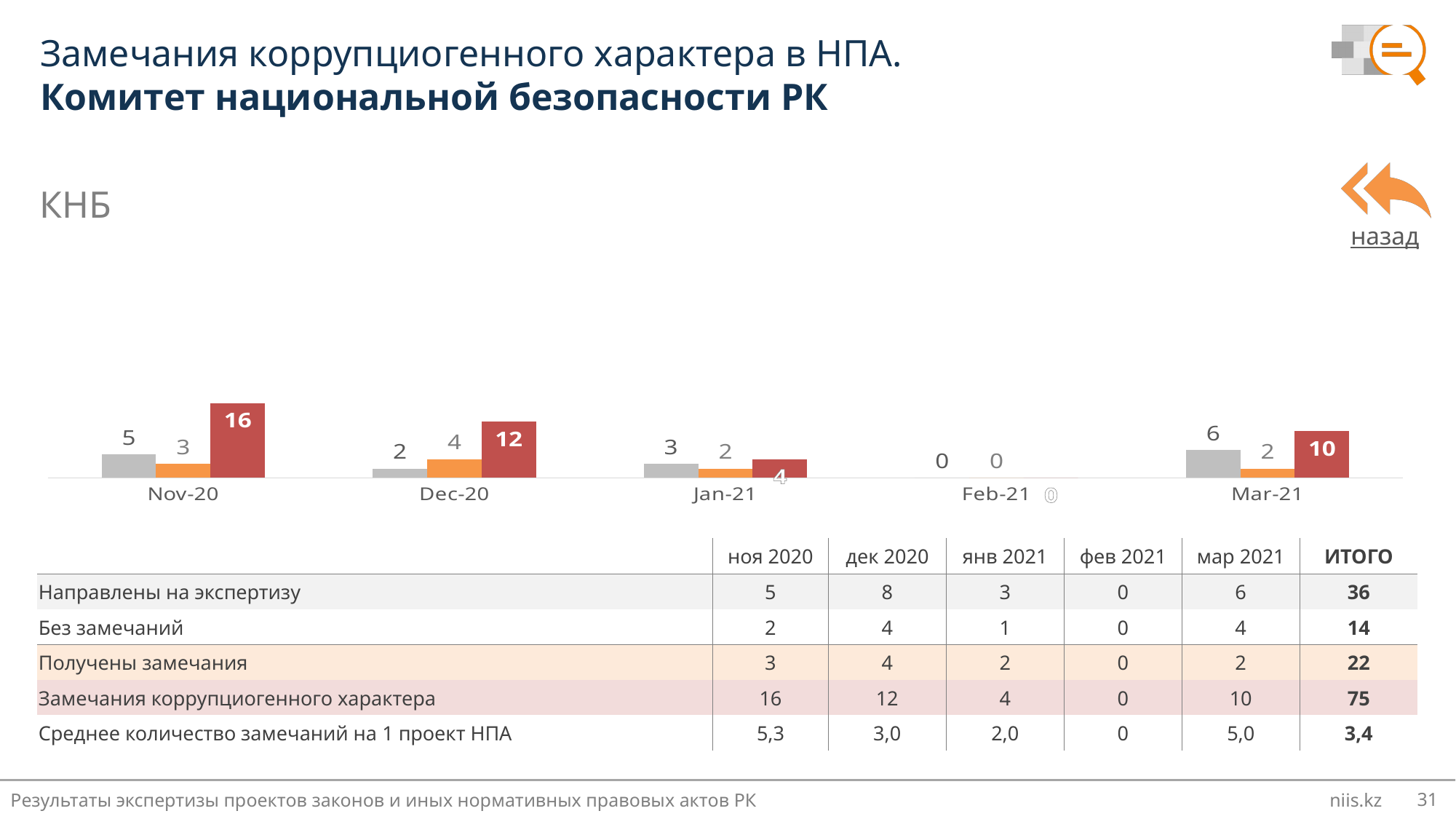
What is the value of the orange bar for Dec-20? 4 How many month categories are shown on the x axis of the chart? 5 What is the value of the red bar for Nov-20? 16 What kind of chart is shown on the slide? bar chart Which month has the highest grey bar? Mar-21 What is the difference between the red bar values for Nov-20 and Mar-21? 6 Which is larger, the red bar for Dec-20 or the red bar for Jan-21? Dec-20 What are the values of all three bars for Feb-21? 0 What is the value of the red bar for Dec-20? 12 What is the value of the red bar for Mar-21? 10 What is the value of the grey bar for Mar-21? 6 Which month has the highest red bar? Nov-20